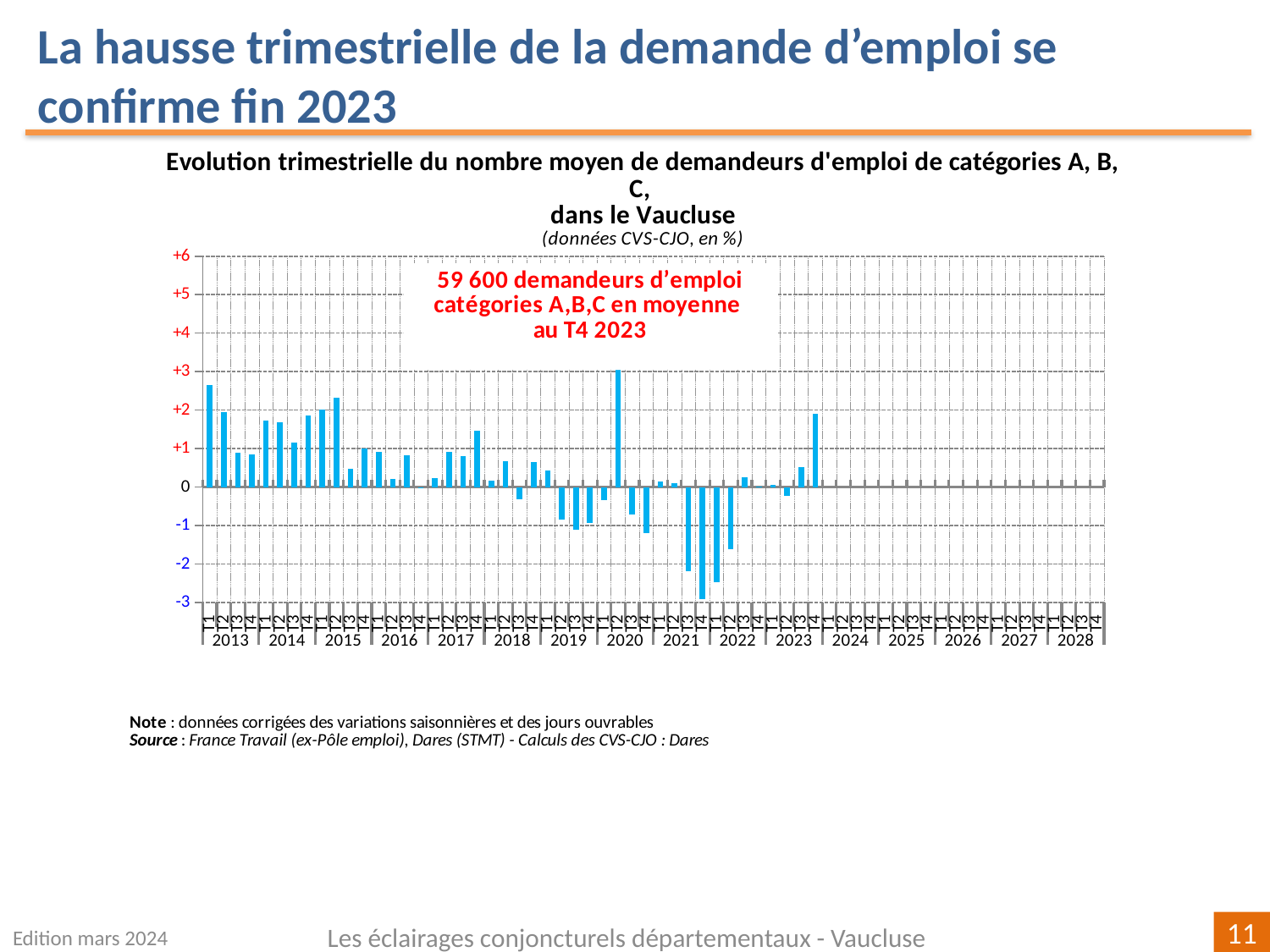
Is the value for T3 2023 greater or less than 0? greater What kind of chart is shown on the slide? bar chart Which quarter has the highest bar in the chart? T2 2020 Which is larger, the value for T1 2013 or the value for T2 2013? T1 2013 Which is larger, the value for T2 2020 or the value for T4 2023? T2 2020 Is the value for T4 2023 greater or less than +1? greater How many years are labelled along the x axis of the chart? 16 Is the value for T1 2013 greater or less than +2? greater According to the text box on the chart, how many demandeurs d'emploi catégories A,B,C were there on average in T4 2023? 59 600 Which quarter has the lowest bar in the chart? T4 2021